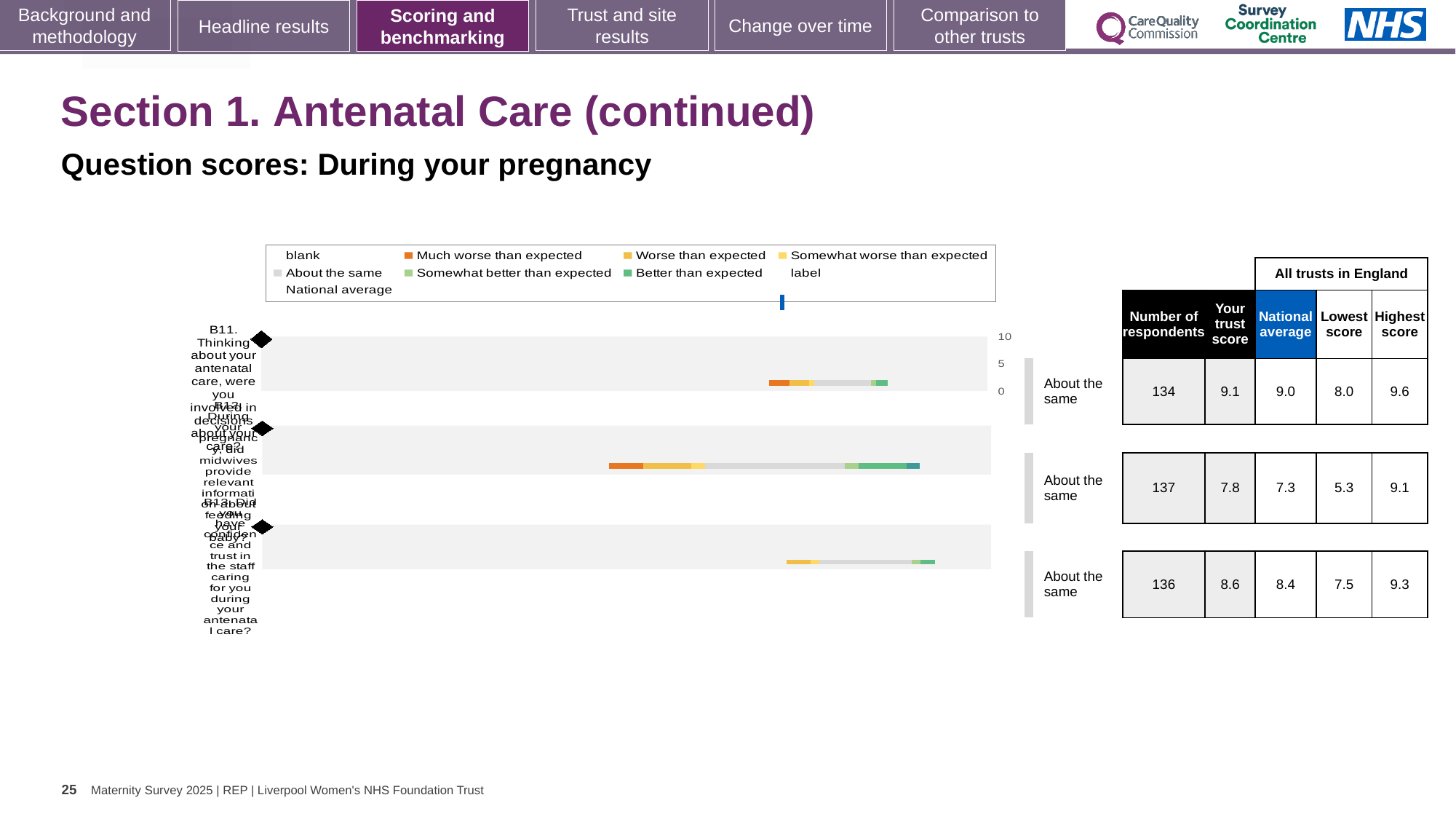
Which question has the lowest 'Your trust score'? B12 What colour does the legend use for 'Much worse than expected'? orange Which question has the highest 'Your trust score'? B11 How many respondents are listed for question B13? 136 How many questions (categories) are plotted in the chart? 3 What is the 'Your trust score' value for question B11? 9.1 What benchmark category is shown for question B12? About the same What kind of chart is shown on the slide? bar chart What is the difference between the highest score and the lowest score for question B12? 3.8 For question B13, which is larger: the trust score or the national average? the trust score (8.6) What is the lowest score across all trusts in England for question B13? 7.5 What is the national average for question B12? 7.3